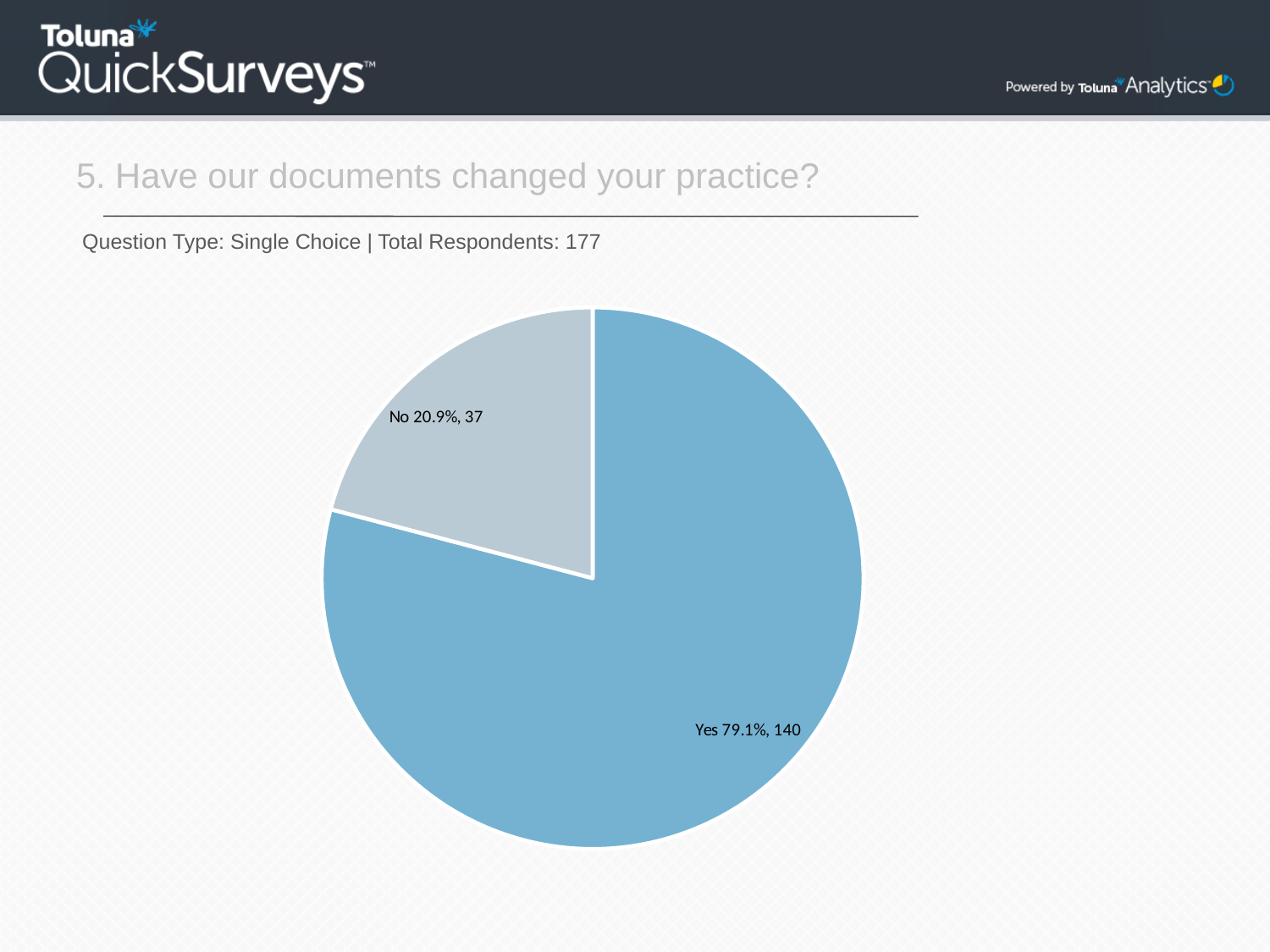
What percentage of respondents answered "Yes"? 79.1% How many respondents answered "Yes"? 140 How many more respondents answered "Yes" than "No"? 103 What kind of chart is shown on the slide? Pie chart How many slices does the pie chart have? 2 What is the survey question shown above the chart? 5. Have our documents changed your practice? How many respondents answered "No"? 37 What percentage of respondents answered "No"? 20.9% Which response had more respondents, "Yes" or "No"? Yes Which response has the smallest slice of the pie? No Which response has the largest slice of the pie? Yes What is the total number of respondents shown for this question? 177